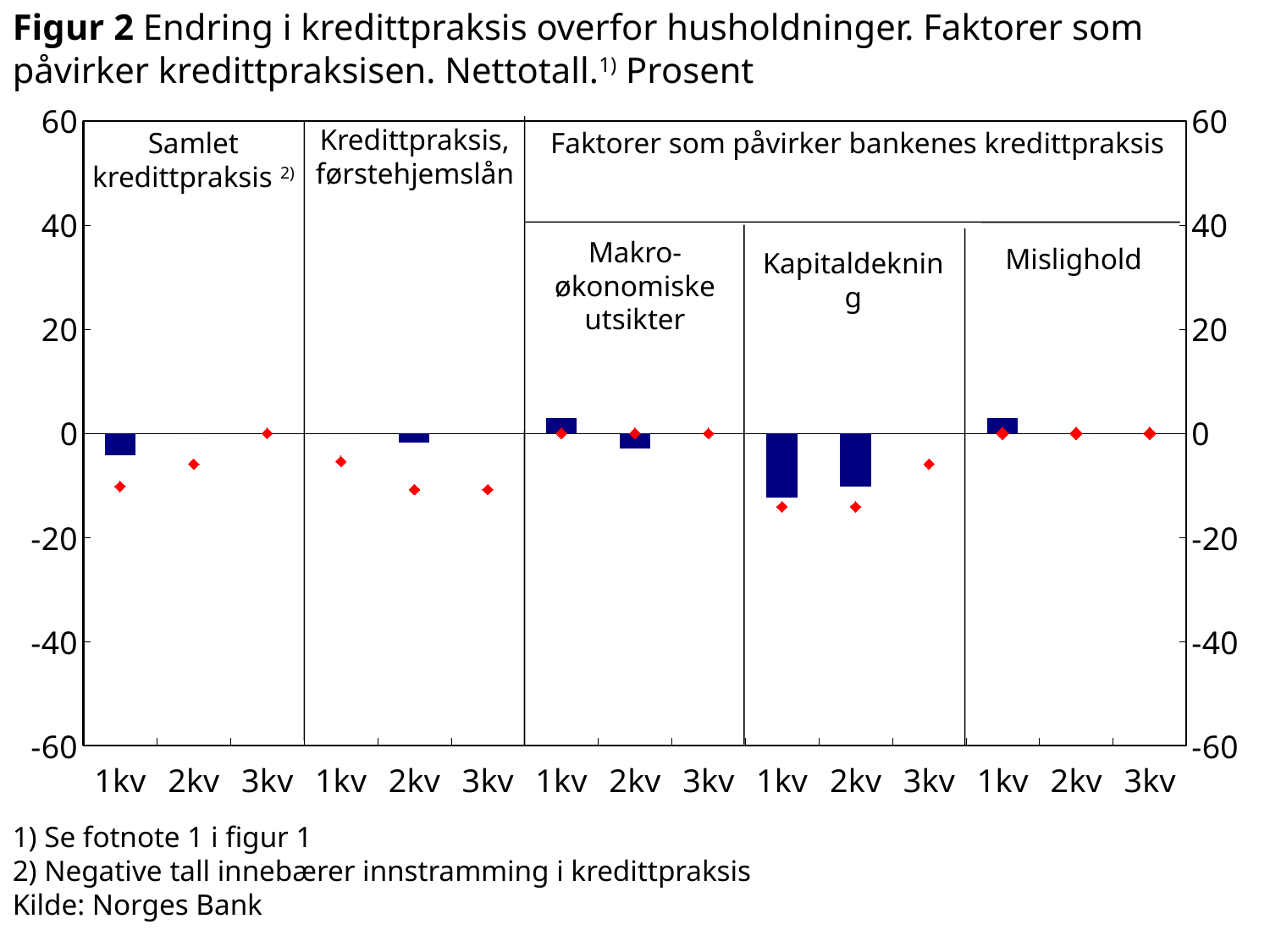
How many factor panels are shown under the heading 'Faktorer som påvirker bankenes kredittpraksis'? 3 Which panel contains the lowest (most negative) bar? Kapitaldekning What is the highest value shown on the vertical axis? 60 Is the bar for 1kv in the Kapitaldekning panel greater or less than 0? less What source is given for the chart? Norges Bank Which is lower, the 1kv bar in the Samlet kredittpraksis panel or the 1kv bar in the Kapitaldekning panel? Kapitaldekning 1kv Is the red marker for 1kv in the Samlet kredittpraksis panel greater or less than 0? less Do the red markers in the Samlet kredittpraksis panel rise or fall from 1kv to 3kv? rise What kind of chart is shown on the slide? bar chart Is the bar for 1kv in the Makroøkonomiske utsikter panel greater or less than 0? greater How many quarter categories (1kv, 2kv, 3kv) are shown along the x axis in total? 15